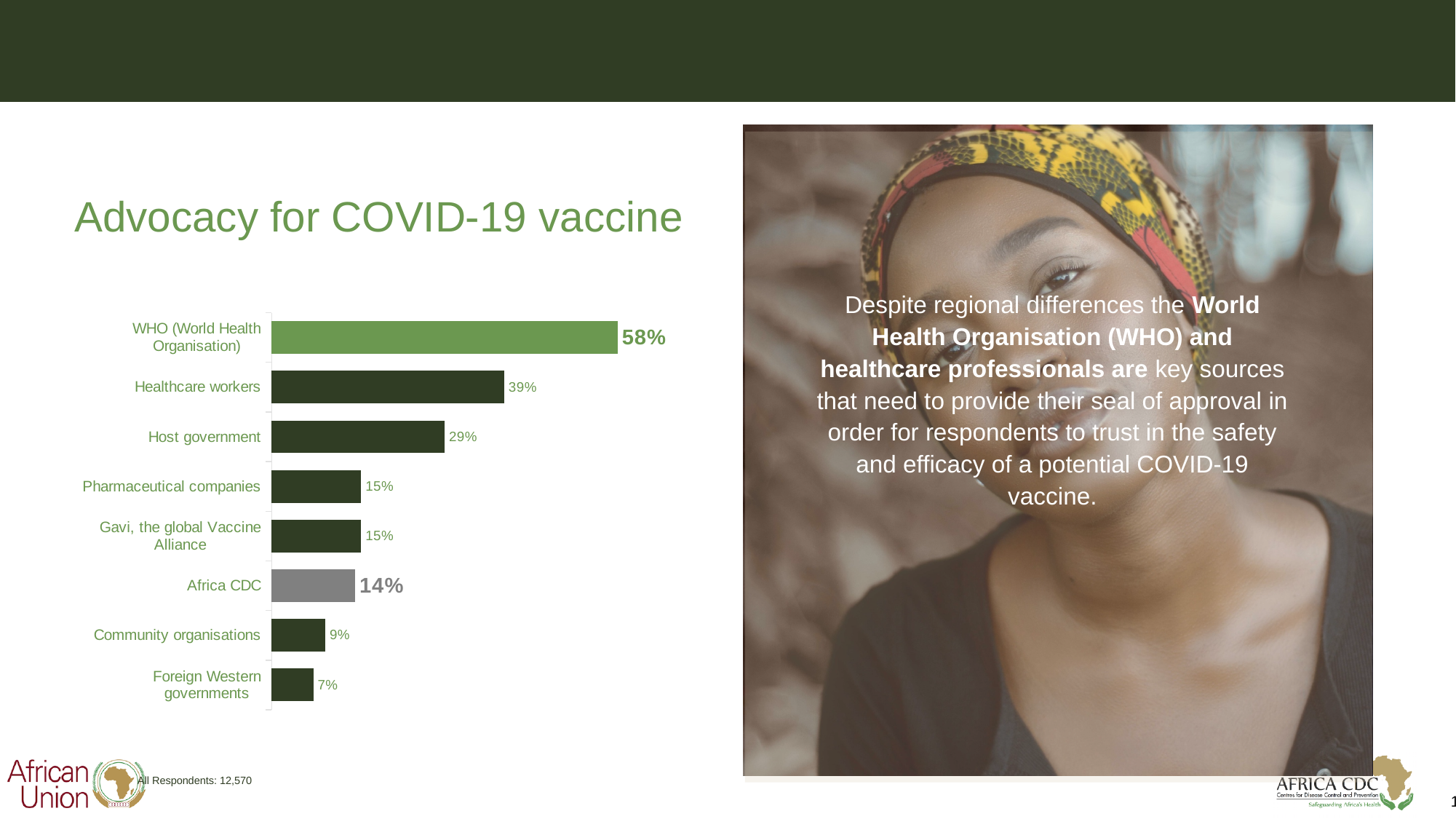
What value is shown for Africa CDC? 14% Which category has the lowest value? Foreign Western governments How many categories are shown in the chart? 8 What is the difference between the values for WHO (World Health Organisation) and Healthcare workers? 19% Which is larger, the value for Host government or the value for Community organisations? Host government What percentage of respondents is shown for WHO (World Health Organisation)? 58% What is the difference between the values for Host government and Africa CDC? 15% What is the title of the slide containing the chart? Advocacy for COVID-19 vaccine What value is shown for Healthcare workers? 39% What kind of chart is shown on the slide? Bar chart Which category has the highest value? WHO (World Health Organisation) What value is shown for Foreign Western governments? 7%